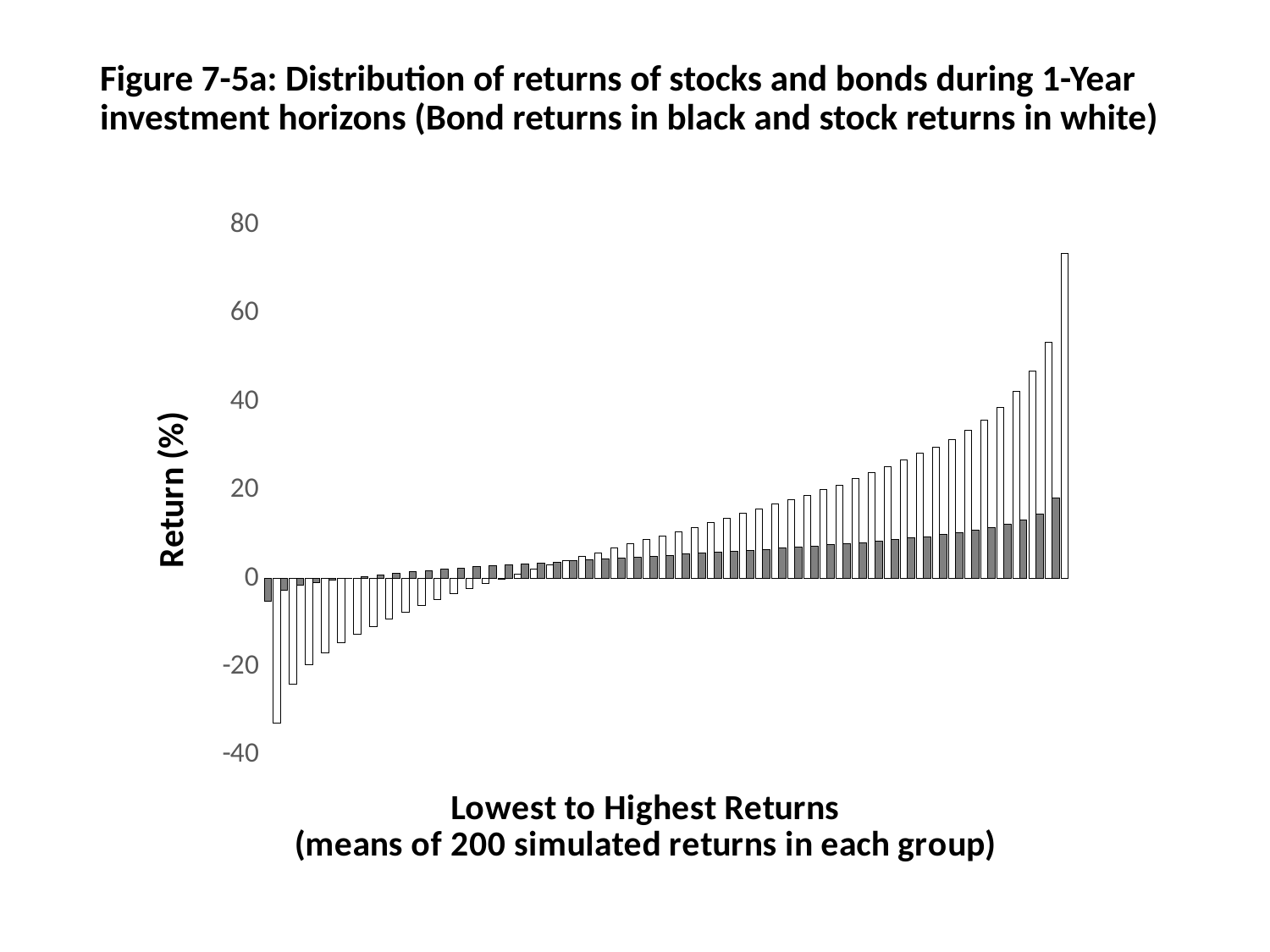
What kind of chart is shown on the slide? bar chart Is the highest bond return (rightmost black bar) greater or less than 40? less Is the highest bond return (rightmost black bar) greater or less than 10? greater Which series has the lower minimum value, bond returns (black) or stock returns (white)? stock returns (white) Is the highest stock return (rightmost white bar) greater or less than 60? greater What is the label of the vertical axis? Return (%) What is the title of the chart on the slide? Figure 7-5a: Distribution of returns of stocks and bonds during 1-Year investment horizons (Bond returns in black and stock returns in white) What is the highest tick value shown on the vertical axis? 80 Do the stock returns (white bars) rise or fall from left to right along the x axis? rise Which series reaches the higher maximum value, bond returns (black) or stock returns (white)? stock returns (white)